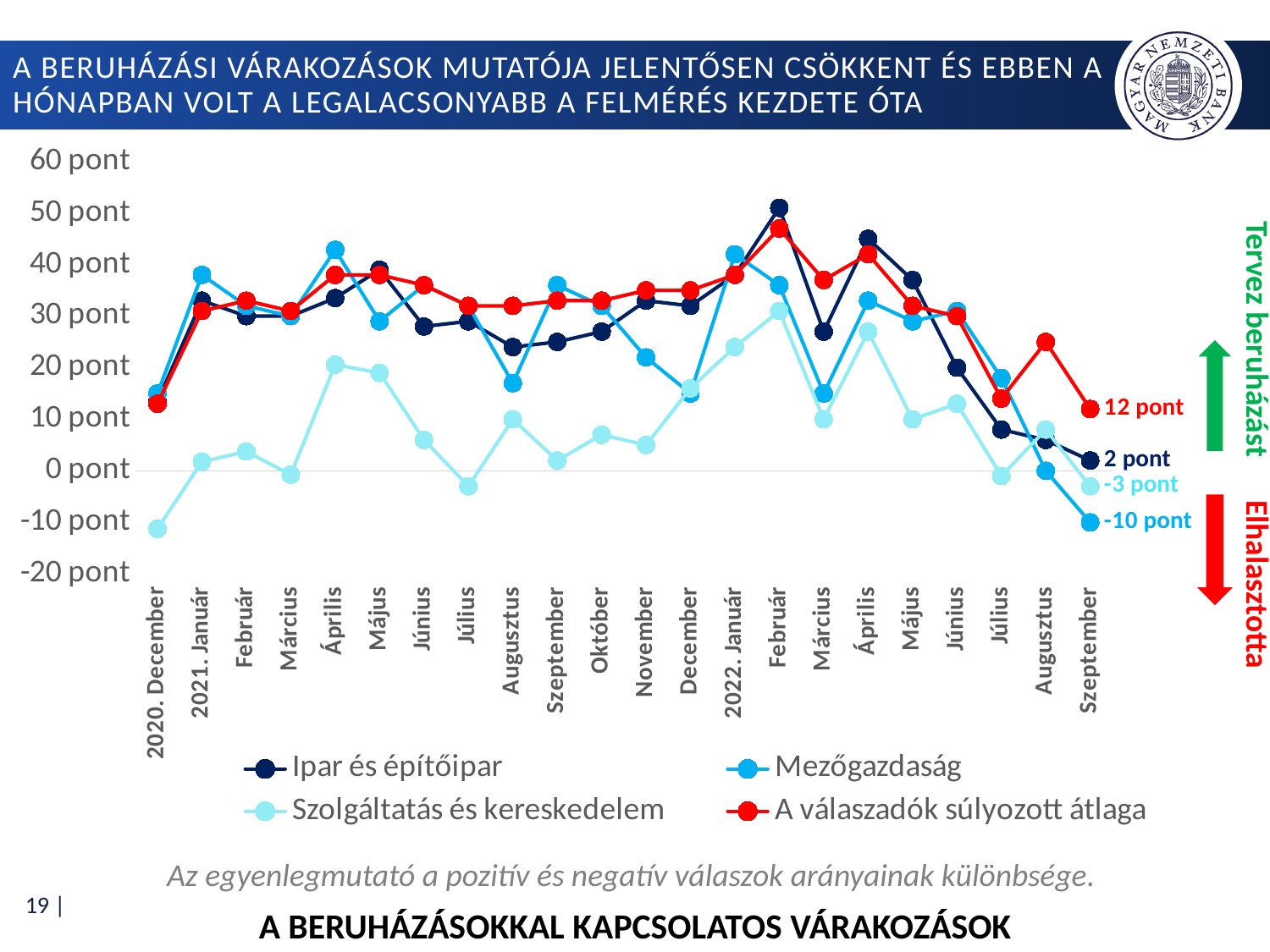
What value does the 'Mezőgazdaság' series show for 2022 Szeptember? -10 pont Does the 'A válaszadók súlyozott átlaga' series rise or fall from 2022 Február to 2022 Szeptember? Fall Is the value for 'Szolgáltatás és kereskedelem' in 2020 December greater or less than 0 pont? less Is the value for 'Ipar és építőipar' in 2022 Február greater or less than 40 pont? greater Which series has the highest value in 2022 Szeptember? A válaszadók súlyozott átlaga What value does the 'Ipar és építőipar' series show for 2022 Szeptember? 2 pont Which series has the lowest value in 2022 Szeptember? Mezőgazdaság What kind of chart is shown on the slide? Line chart What value does the 'A válaszadók súlyozott átlaga' series show for 2022 Szeptember? 12 pont How many series does the legend list? 4 What is the difference between the 'A válaszadók súlyozott átlaga' and 'Mezőgazdaság' values in 2022 Szeptember? 22 pont What value does the 'Szolgáltatás és kereskedelem' series show for 2022 Szeptember? -3 pont